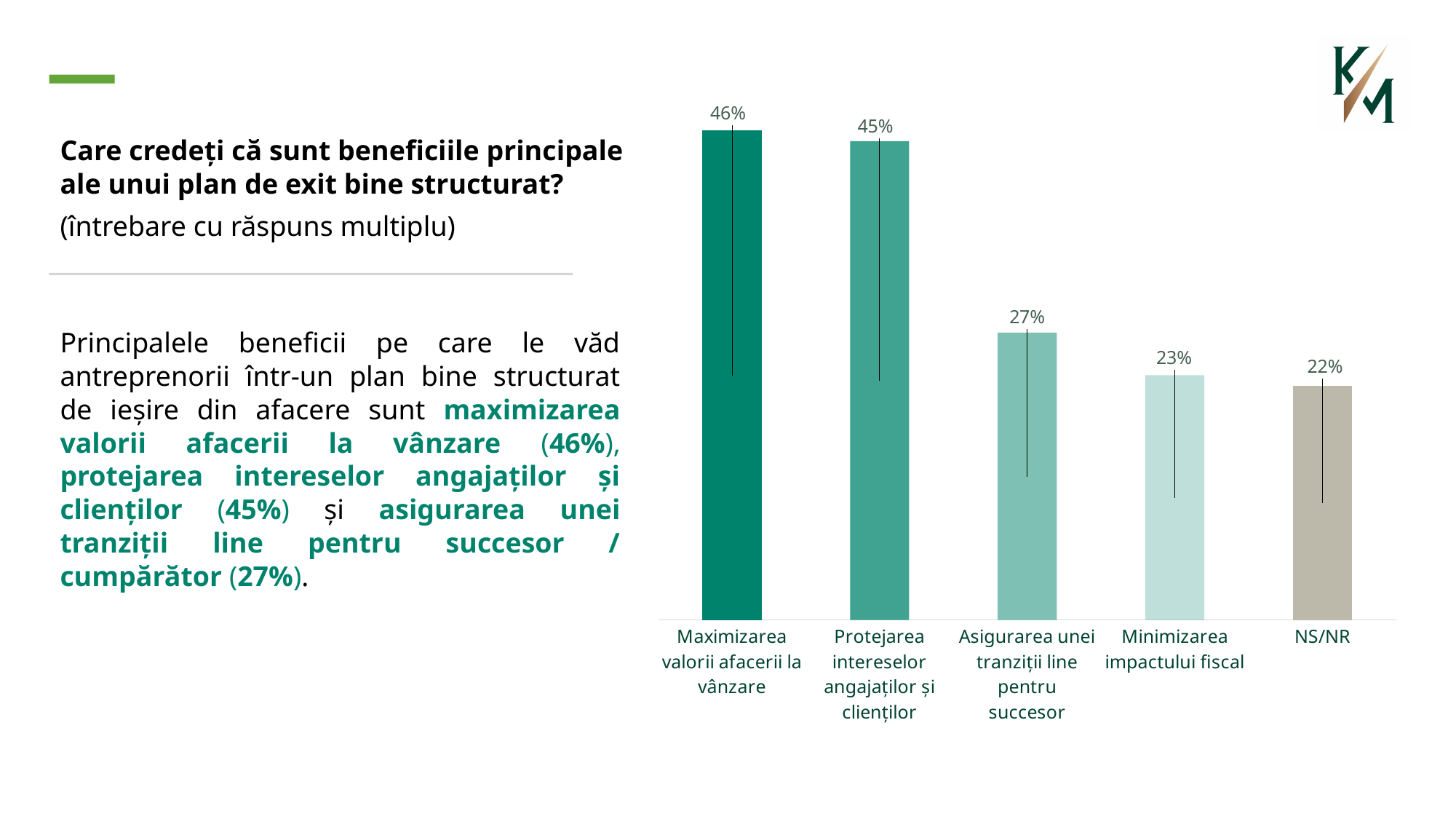
Which is larger: the value for "Asigurarea unei tranziții line pentru succesor" or the value for "Minimizarea impactului fiscal"? Asigurarea unei tranziții line pentru succesor Which category has the highest value? Maximizarea valorii afacerii la vânzare What is the value for "Maximizarea valorii afacerii la vânzare"? 46% What is the value for "NS/NR"? 22% How many categories are shown in the chart? 5 What is the value for "Minimizarea impactului fiscal"? 23% What is the difference between the values for "Maximizarea valorii afacerii la vânzare" and "Asigurarea unei tranziții line pentru succesor"? 19% What is the value for "Protejarea intereselor angajaților și clienților"? 45% What kind of chart is shown on the slide? Bar chart Which category has the lowest value? NS/NR What is the value for "Asigurarea unei tranziții line pentru succesor"? 27% What is the difference between the values for "Protejarea intereselor angajaților și clienților" and "Minimizarea impactului fiscal"? 22%